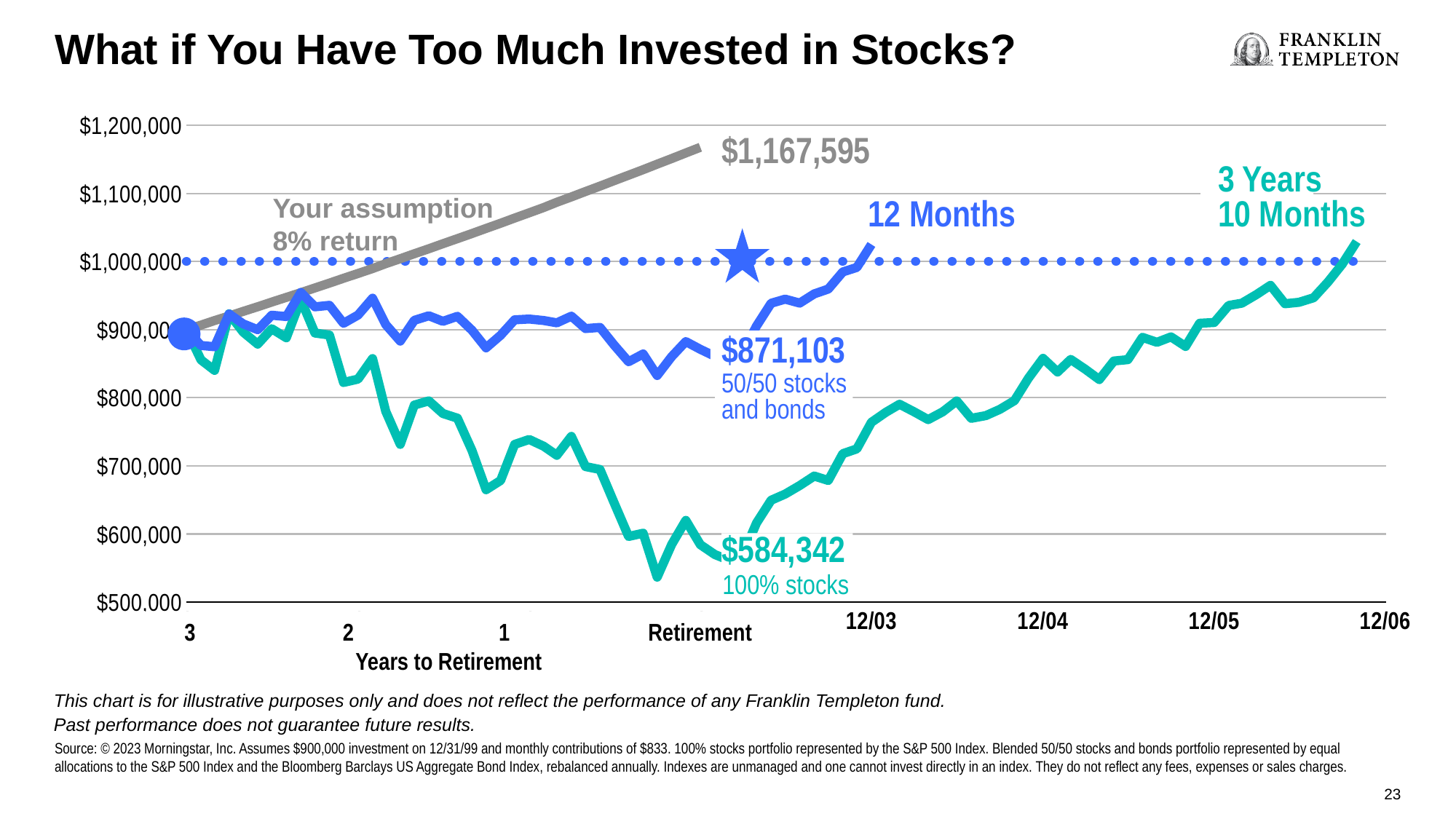
What value does the 'Your assumption 8% return' line reach at retirement? $1,167,595 Which portfolio has the lowest value at retirement? 100% stocks What is the value of the 50/50 stocks and bonds portfolio at retirement? $871,103 At retirement, which is larger: the 50/50 stocks and bonds portfolio or the 100% stocks portfolio? 50/50 stocks and bonds How long does the 100% stocks portfolio take after retirement to reach the $1,000,000 dotted line? 3 Years 10 Months What is the difference between the 50/50 stocks and bonds value and the 100% stocks value at retirement? $286,761 Is the value of the 100% stocks line at 12/04 greater or less than $900,000? less How long does the 50/50 stocks and bonds portfolio take after retirement to reach the $1,000,000 dotted line? 12 Months What is the title of the x axis? Years to Retirement What kind of chart is shown on the slide? Line chart How much higher is the 8% return assumption value than the 50/50 stocks and bonds value at retirement? $296,492 What is the value of the 100% stocks portfolio at retirement? $584,342